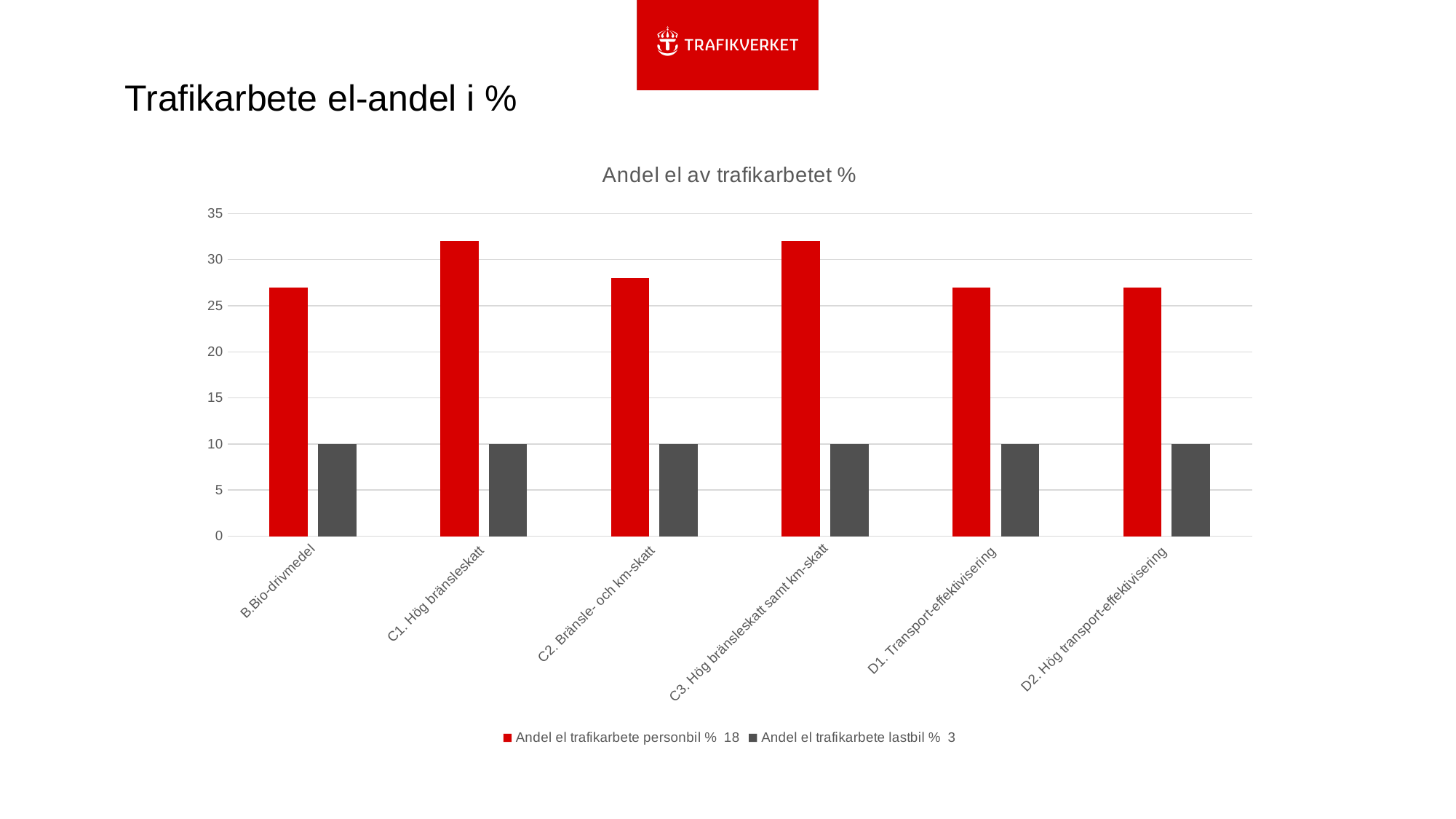
What is the title of the chart? Andel el av trafikarbetet % Is the value of 'Andel el trafikarbete personbil %' for C1. Hög bränsleskatt greater or less than 30? greater How many categories are shown on the x axis? 6 Is the value of 'Andel el trafikarbete personbil %' for C2. Bränsle- och km-skatt greater or less than 25? greater Is the value of 'Andel el trafikarbete personbil %' for B.Bio-drivmedel greater or less than 30? less How many series does the legend list? 2 What is the value of 'Andel el trafikarbete lastbil %' for D2. Hög transport-effektivisering? 10 Which has the larger 'Andel el trafikarbete personbil %' value, B.Bio-drivmedel or C1. Hög bränsleskatt? C1. Hög bränsleskatt Which has the larger 'Andel el trafikarbete personbil %' value, C2. Bränsle- och km-skatt or C3. Hög bränsleskatt samt km-skatt? C3. Hög bränsleskatt samt km-skatt What is the value of 'Andel el trafikarbete lastbil %' for B.Bio-drivmedel? 10 Which colour represents the 'Andel el trafikarbete lastbil %' series? grey What kind of chart is shown on the slide? bar chart